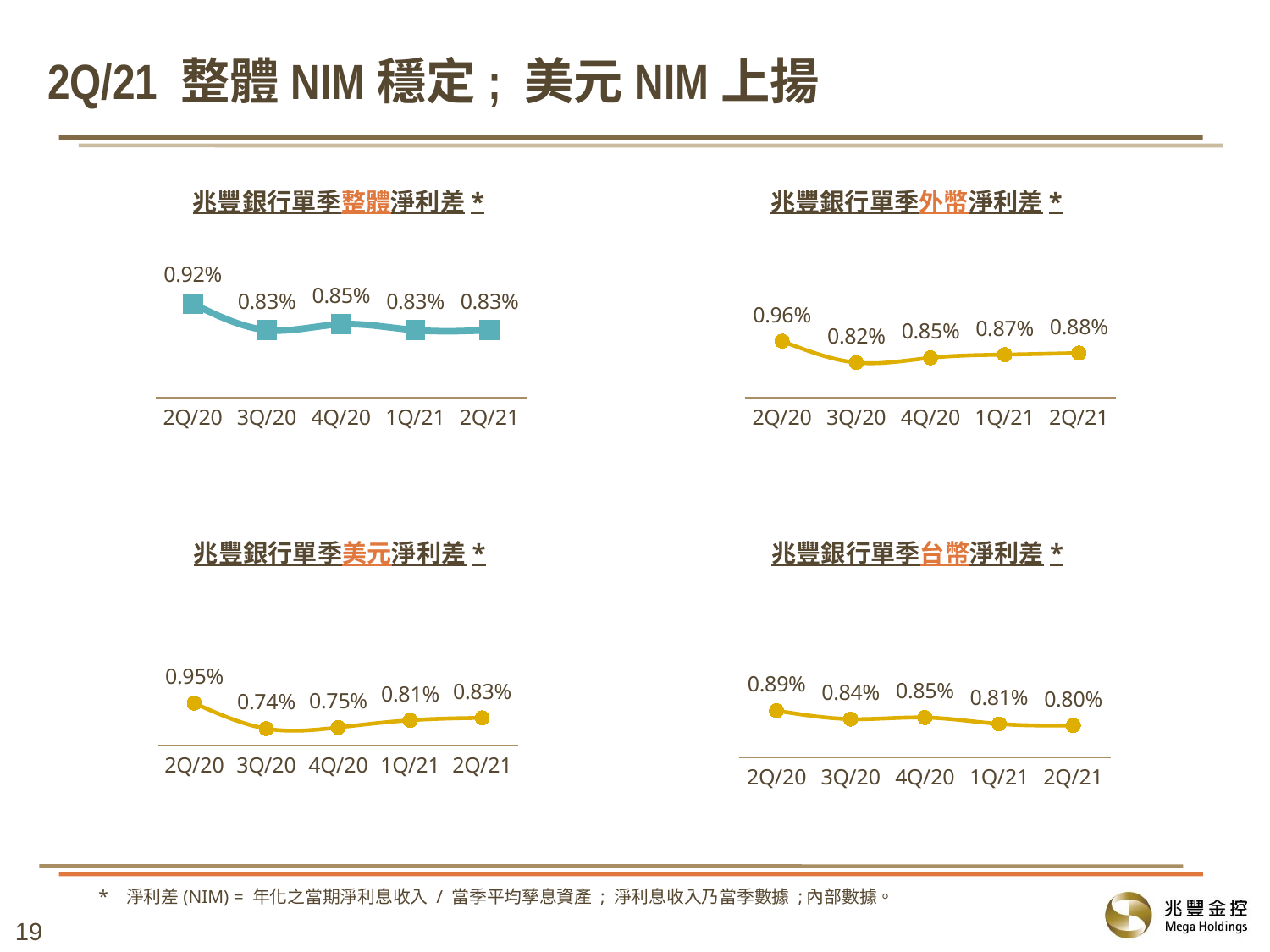
In the bottom-left chart (兆豐銀行單季美元淨利差), which is larger, the value for 1Q/21 or the value for 2Q/21? 2Q/21 In the bottom-left chart (兆豐銀行單季美元淨利差), do the values rise or fall from 3Q/20 to 2Q/21? Rise In the bottom-right chart (兆豐銀行單季台幣淨利差), what is the value for 1Q/21? 0.81% In the bottom-left chart (兆豐銀行單季美元淨利差), which quarter has the highest value? 2Q/20 In the top-right chart (兆豐銀行單季外幣淨利差), what is the value for 2Q/21? 0.88% In the top-left chart (兆豐銀行單季整體淨利差), what is the value for 2Q/20? 0.92% In the bottom-right chart (兆豐銀行單季台幣淨利差), which quarter has the lowest value? 2Q/21 In the bottom-left chart (兆豐銀行單季美元淨利差), what is the value for 3Q/20? 0.74% How many quarters are plotted in the top-left chart (兆豐銀行單季整體淨利差)? 5 What kind of chart is the top-right chart (兆豐銀行單季外幣淨利差)? Line chart In the top-right chart (兆豐銀行單季外幣淨利差), what is the difference between the 2Q/20 value and the 3Q/20 value? 0.14% How many charts are shown on the slide? 4